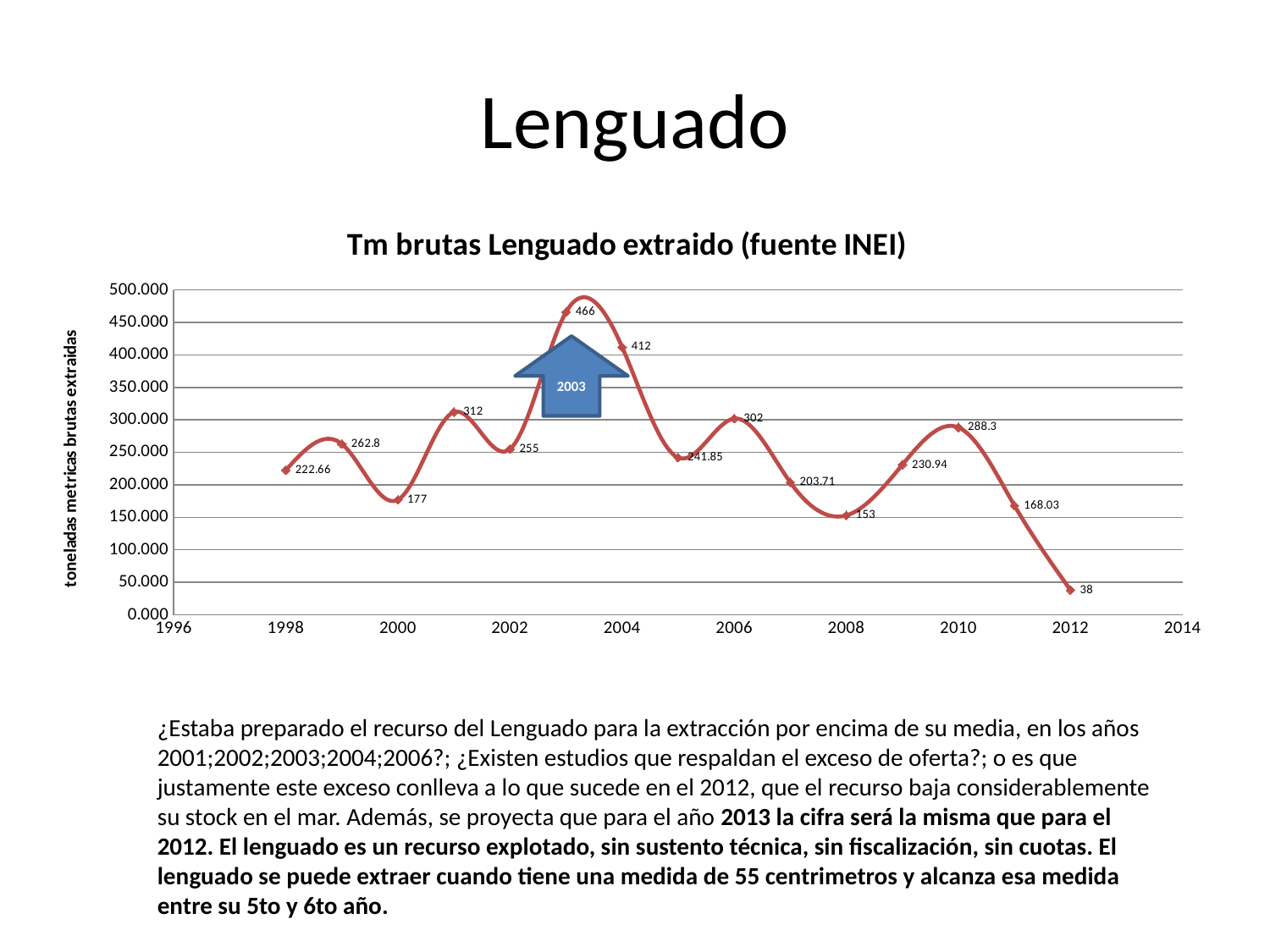
What is the difference between the values for 2001 and 2000? 135 What is the value plotted for the year 2003? 466 Which year has the highest value on the chart? 2003 Which year has the lowest value on the chart? 2012 What is the title of the chart? Tm brutas Lenguado extraido (fuente INEI) What kind of chart is shown on the slide? line chart How many data points are plotted on the chart? 15 What is the value plotted for the year 2012? 38 Which year has the larger value, 2006 or 2010? 2006 Is the value for 2008 greater or less than 200.000? less What is the difference between the values for 2003 and 2004? 54 What is the value plotted for the year 2009? 230.94